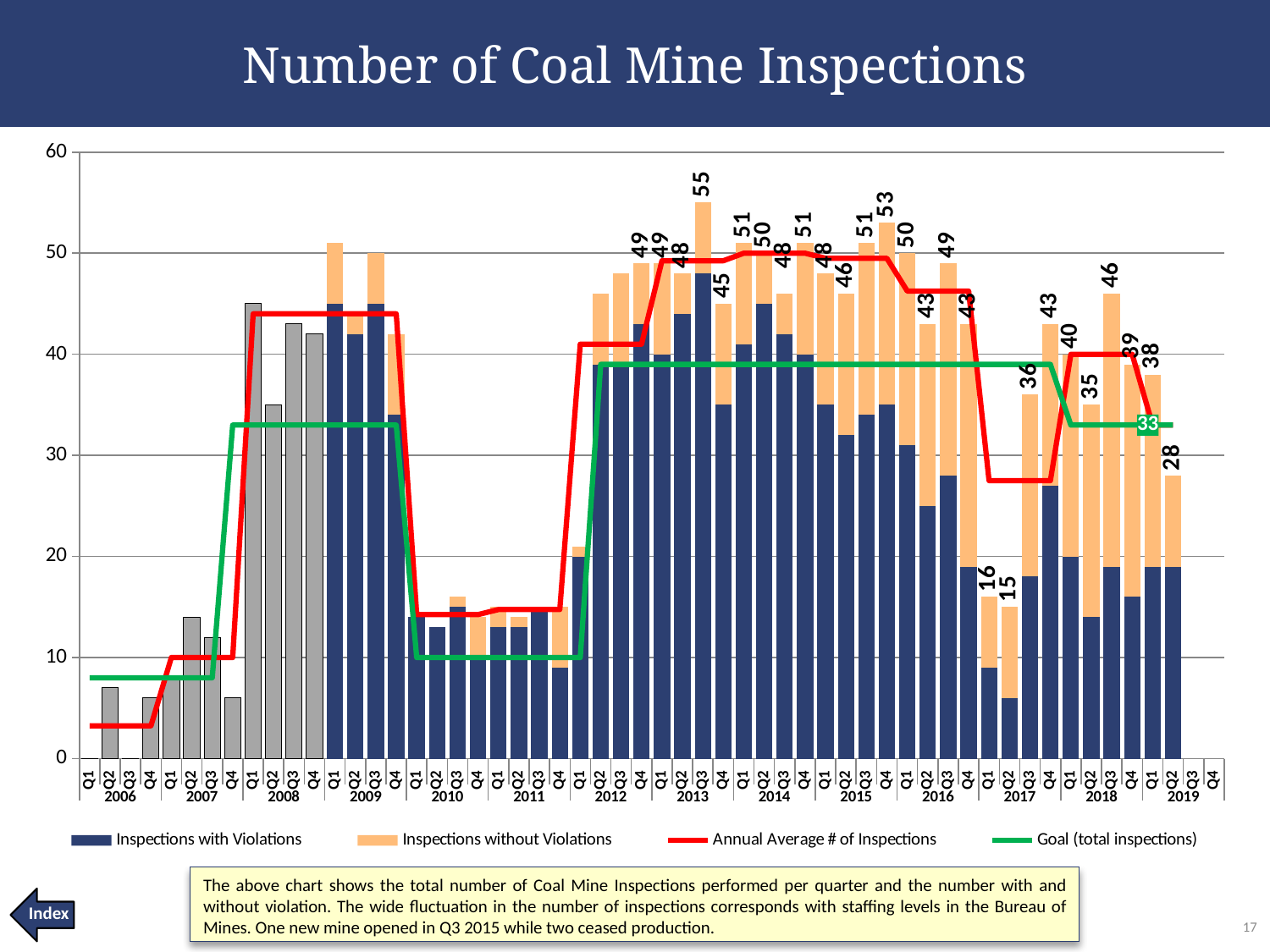
What is the difference between the total inspections in Q3 2013 and Q2 2019? 27 Do the total inspections rise or fall from Q3 2018 to Q2 2019? fall Is the total number of inspections in Q1 2008 greater or less than 40? greater Which quarter has the highest labelled total number of inspections? Q3 2013 What kind of chart is shown on the slide? bar and line chart What was the total number of coal mine inspections in Q2 2019? 28 What was the total number of coal mine inspections in Q2 2017? 15 Which quarter had more total inspections, Q4 2015 or Q1 2016? Q4 2015 Is the total number of inspections in Q2 2010 greater or less than 20? less How many series does the legend list? 4 What was the total number of coal mine inspections in Q3 2013? 55 Which series is drawn as the red line? Annual Average # of Inspections